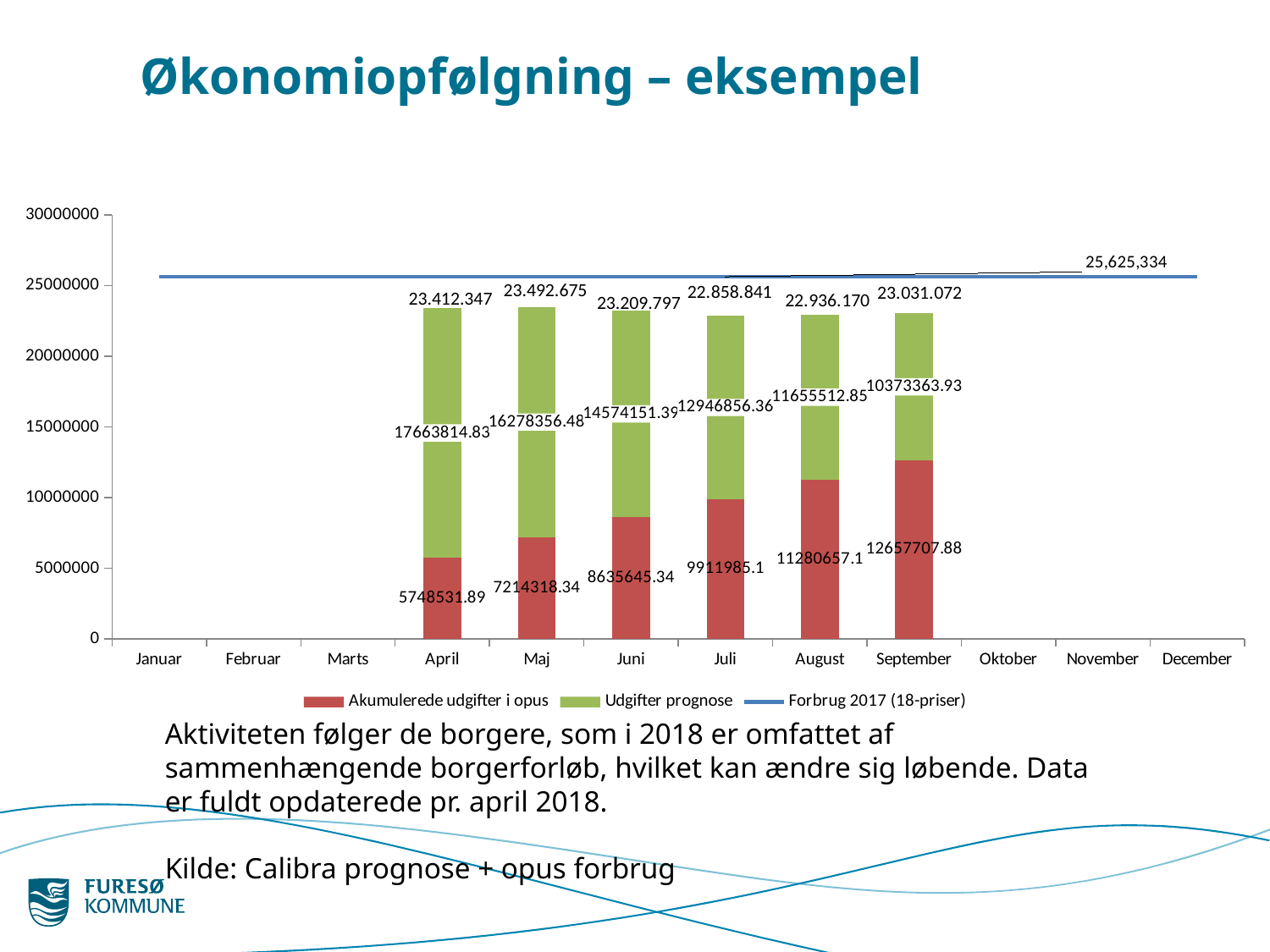
Do the Akumulerede udgifter i opus values rise or fall from April to September? rise How many series does the legend list? 3 What kind of chart is shown on the slide? Stacked bar chart with a line How many months have stacked bars plotted in the chart? 6 Is the Akumulerede udgifter i opus value for August greater or less than 10000000? greater What is the value of Akumulerede udgifter i opus for April? 5748531.89 What is the value of Udgifter prognose for September? 10373363.93 Which month has the highest value for Akumulerede udgifter i opus? September What is the value of the Forbrug 2017 (18-priser) line? 25,625,334 Which month has the lowest value for Udgifter prognose? September Is the Akumulerede udgifter i opus value for Juli larger or smaller than the Udgifter prognose value for Juli? smaller What is the total labelled above the stacked bar for Maj? 23.492.675